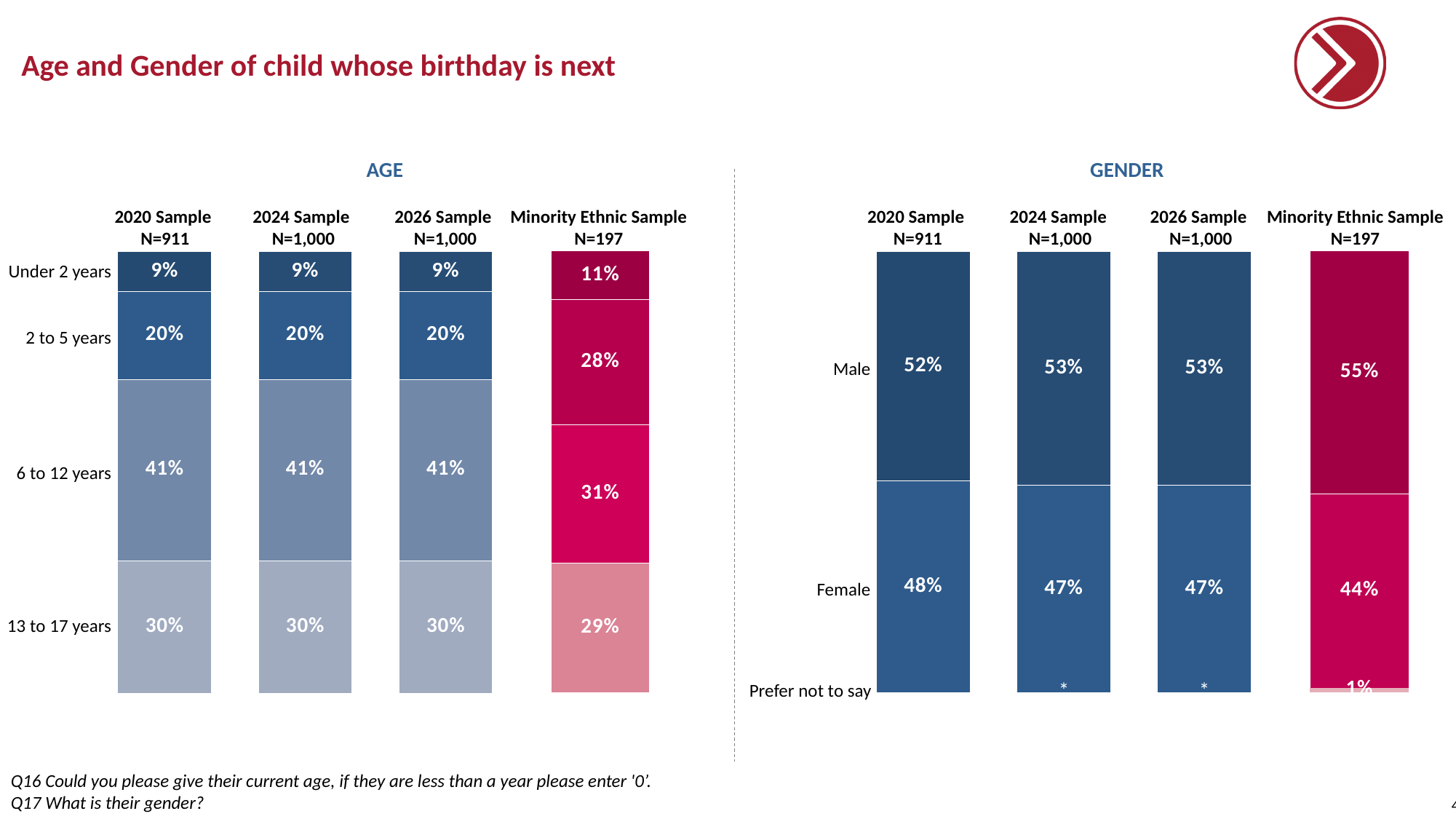
In the GENDER chart, what percentage of the Minority Ethnic Sample is Male? 55% In the GENDER chart, is the Female share larger in the 2020 Sample or the Minority Ethnic Sample? 2020 Sample How many sample bars are shown in the AGE chart? 4 In the AGE chart, what is the difference between the 6 to 12 years share in the 2026 Sample and in the Minority Ethnic Sample? 10 percentage points In the AGE chart, which age group has the smallest share in the Minority Ethnic Sample? Under 2 years In the GENDER chart, what is the difference between the Male and Female shares in the 2024 Sample? 6 percentage points In the GENDER chart, what percentage of the 2020 Sample is Female? 48% What type of chart is used for the GENDER section? Stacked bar chart In the AGE chart, is the Under 2 years share larger in the 2020 Sample or the Minority Ethnic Sample? Minority Ethnic Sample In the AGE chart, which age group has the largest share in the 2020 Sample? 6 to 12 years In the AGE chart, what percentage of the Minority Ethnic Sample is 6 to 12 years? 31% In the AGE chart, what percentage of the 2024 Sample is 13 to 17 years? 30%